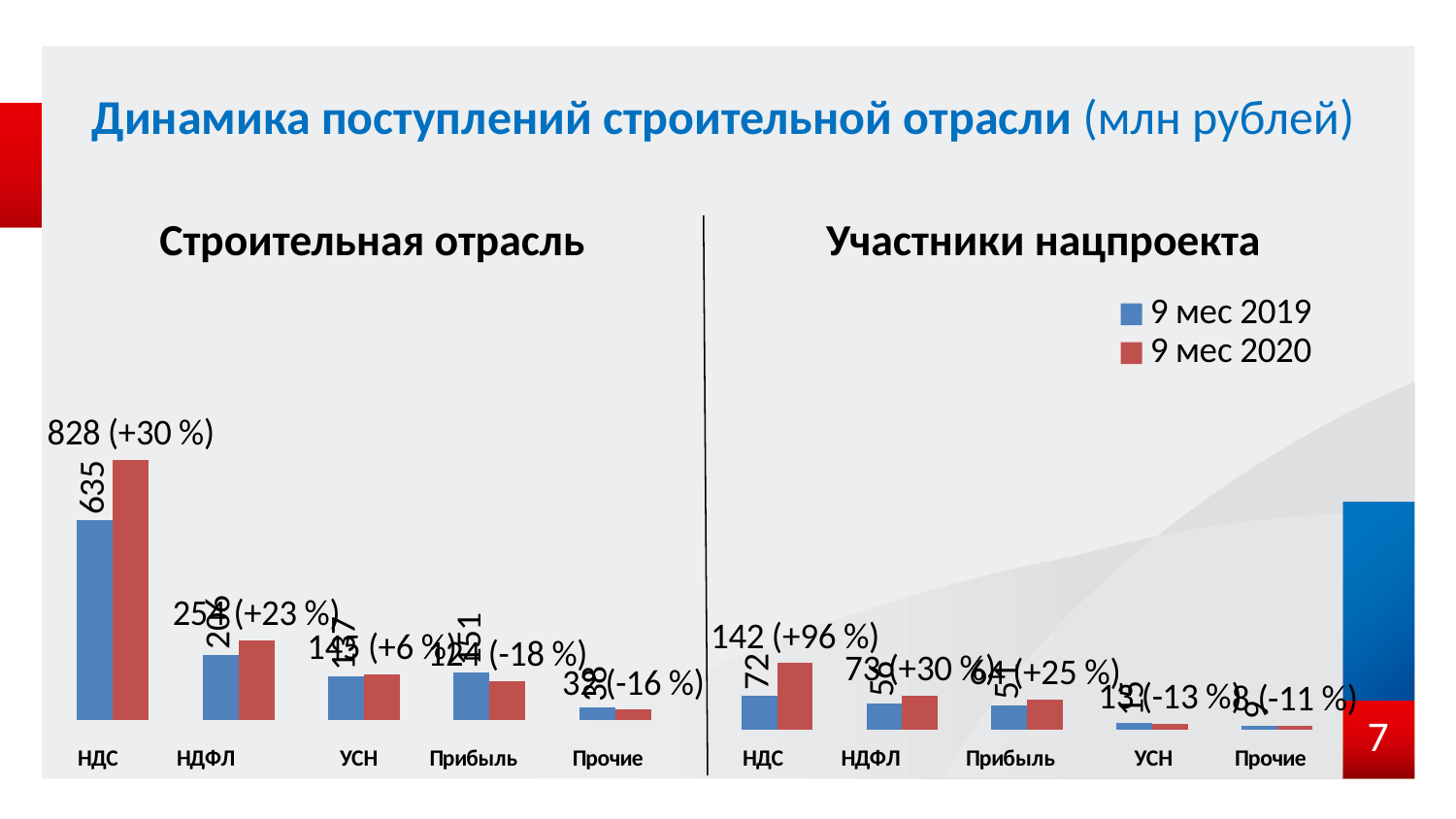
In the Строительная отрасль chart, what is the value for УСН in 9 мес 2019? 137 How many series does the legend list? 2 In the Строительная отрасль chart, which category has the highest value in 9 мес 2020? НДС What kind of chart is the Строительная отрасль chart? Bar chart How many categories are shown in the Участники нацпроекта chart? 5 In the Строительная отрасль chart, by how much did НДС increase from 9 мес 2019 to 9 мес 2020? 193 In the Участники нацпроекта chart, what is the value for НДС in 9 мес 2019? 72 In the Участники нацпроекта chart, what is the value for НДС in 9 мес 2020? 142 In the Участники нацпроекта chart, by how much did НДС increase from 9 мес 2019 to 9 мес 2020? 70 In the Строительная отрасль chart, what is the value for НДС in 9 мес 2019? 635 In the Строительная отрасль chart, which is larger for Прибыль: the 9 мес 2019 value or the 9 мес 2020 value? 9 мес 2019 In the Строительная отрасль chart, what is the value for НДС in 9 мес 2020? 828